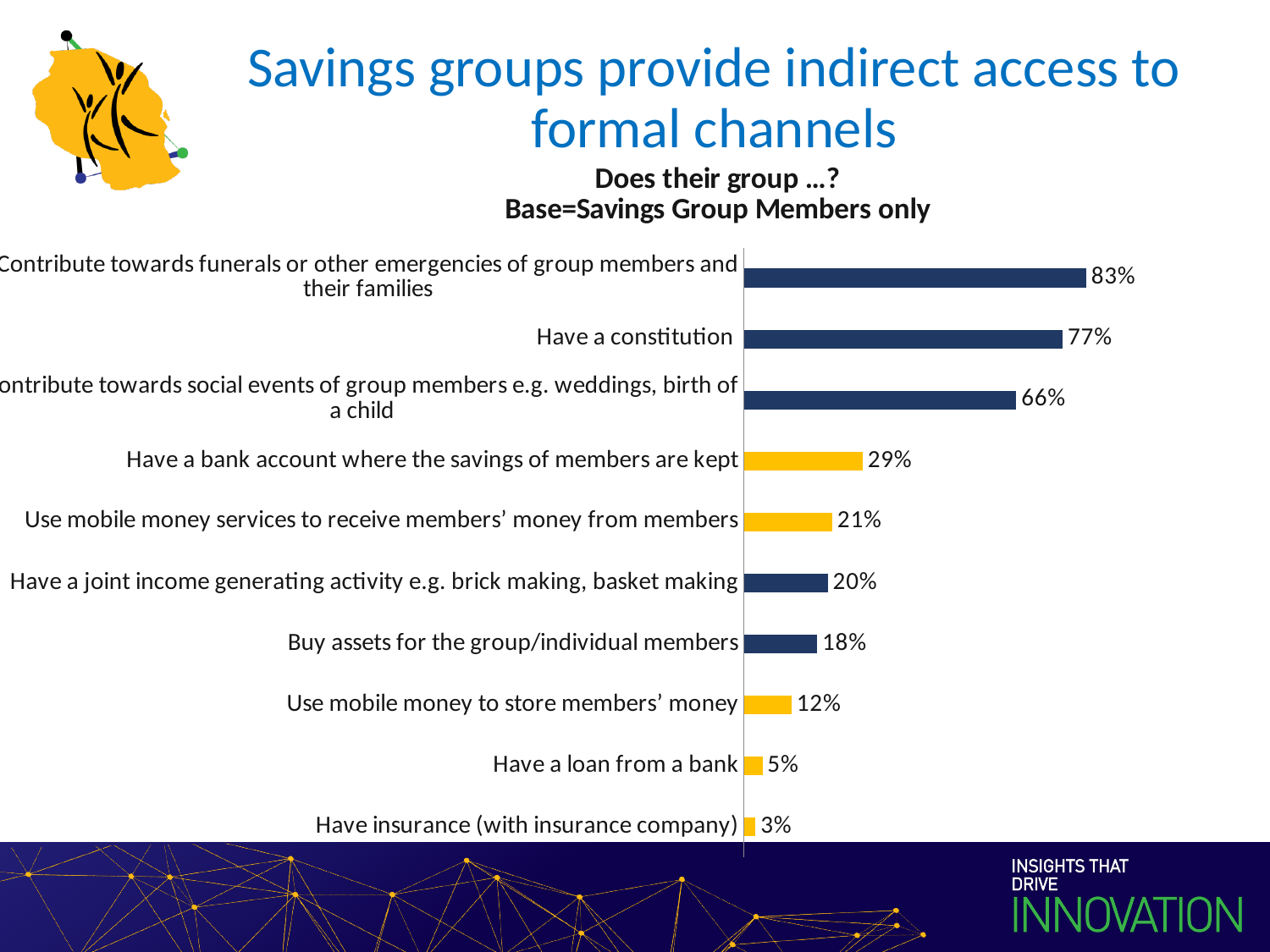
What colour is the bar for 'Have a loan from a bank'? Yellow Which category has the highest value on the chart? Contribute towards funerals or other emergencies of group members and their families What kind of chart is shown on the slide? Bar chart Which category has the lowest value on the chart? Have insurance (with insurance company) What percentage of savings groups have a bank account where the savings of members are kept? 29% What percentage of savings groups use mobile money to store members' money? 12% What is the difference between the percentage that have a constitution and the percentage that have a bank account where the savings of members are kept? 48% What is the base population stated for the chart? Savings Group Members only What is the difference between the percentage that have a loan from a bank and the percentage that have insurance (with insurance company)? 2% What percentage of savings groups have a constitution? 77% Which is larger: the percentage that use mobile money services to receive members' money from members, or the percentage that have a joint income generating activity? Use mobile money services to receive members' money from members How many categories are shown on the chart? 10